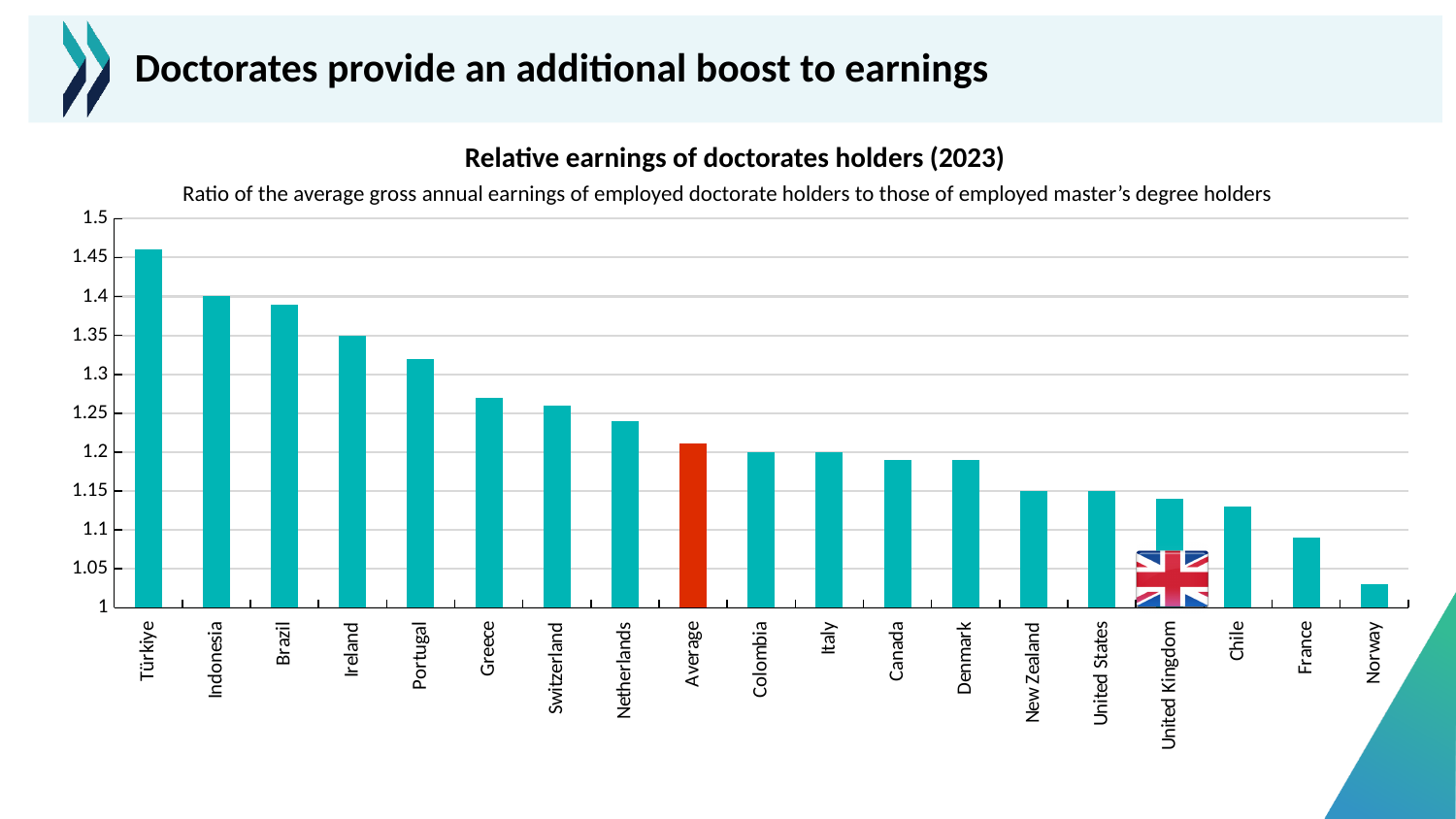
Is the value for the Average bar greater or less than 1.2? greater Do the values rise or fall moving from left to right along the x axis? fall Which bar is shown in a different colour (red) from the others? Average Is the value for France greater or less than 1.1? less Is the value for Türkiye greater or less than 1.45? greater What kind of chart is shown on the slide? bar chart Which country has the lowest relative earnings of doctorate holders? Norway Which has a higher value, Portugal or Greece? Portugal Which country has the highest relative earnings of doctorate holders? Türkiye How many bars are plotted in the chart, including the Average bar? 19